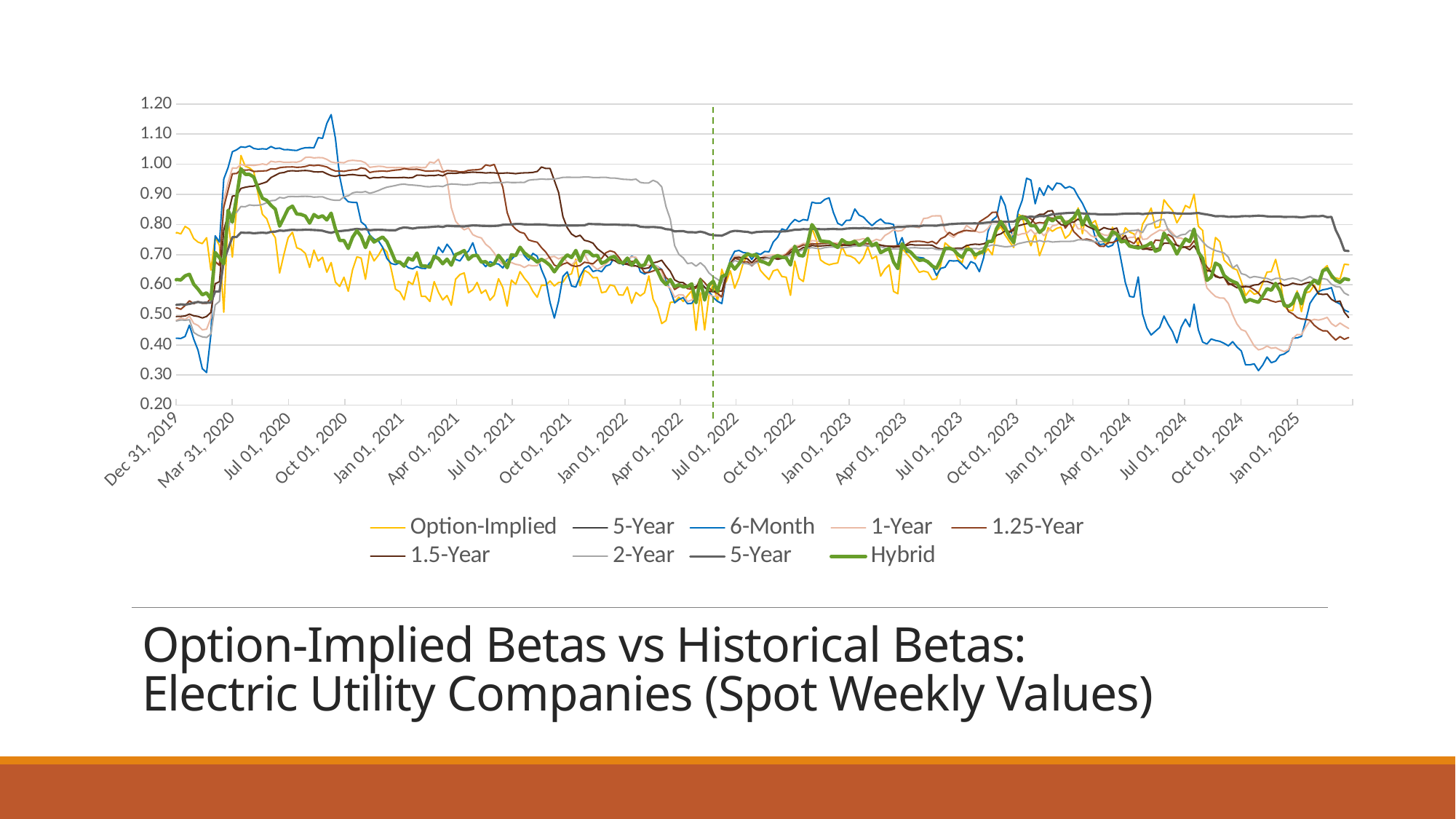
Is the value of the Hybrid series at Dec 31, 2019 greater or less than 0.50? greater How many date labels are shown on the horizontal axis? 21 What is the title of the slide? Option-Implied Betas vs Historical Betas: Electric Utility Companies (Spot Weekly Values) Is the lowest value of the 6-Month series around Oct 01, 2024 greater or less than 0.40? less What is the highest value shown on the vertical axis? 1.20 Is the value of the 2-Year series at Jan 01, 2022 greater or less than 0.90? greater What kind of chart is shown on the slide? Line chart How many series does the legend list? 9 Which series is drawn with the thick green line? Hybrid